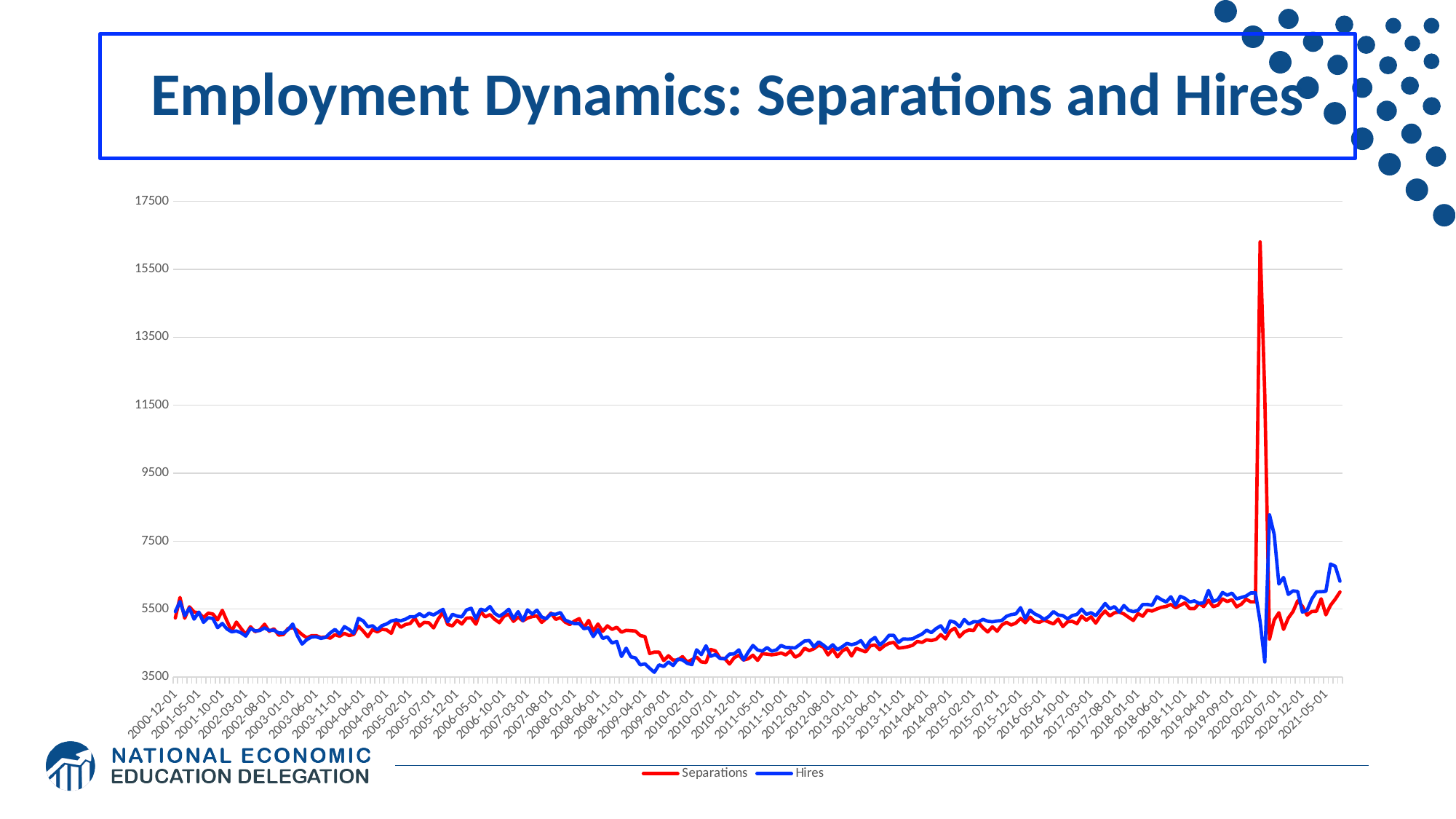
Do the Hires values generally rise or fall between 2010 and 2019? rise Is the peak value of the Hires series in 2020 greater or less than 7500? greater At the 2020 spike, which series has the larger value, Separations or Hires? Separations Is the value of Separations at 2000-12-01 greater or less than 7500? less What kind of chart is shown on the slide? line chart Which series reaches the highest peak on the chart? Separations How many series does the legend list? 2 What is the title of the chart on the slide? Employment Dynamics: Separations and Hires Do the Separations values rise or fall between 2008-01-01 and 2009-09-01? fall Which colour is used for the Hires series? blue Is the peak value of the Separations series in 2020 greater or less than 15500? greater